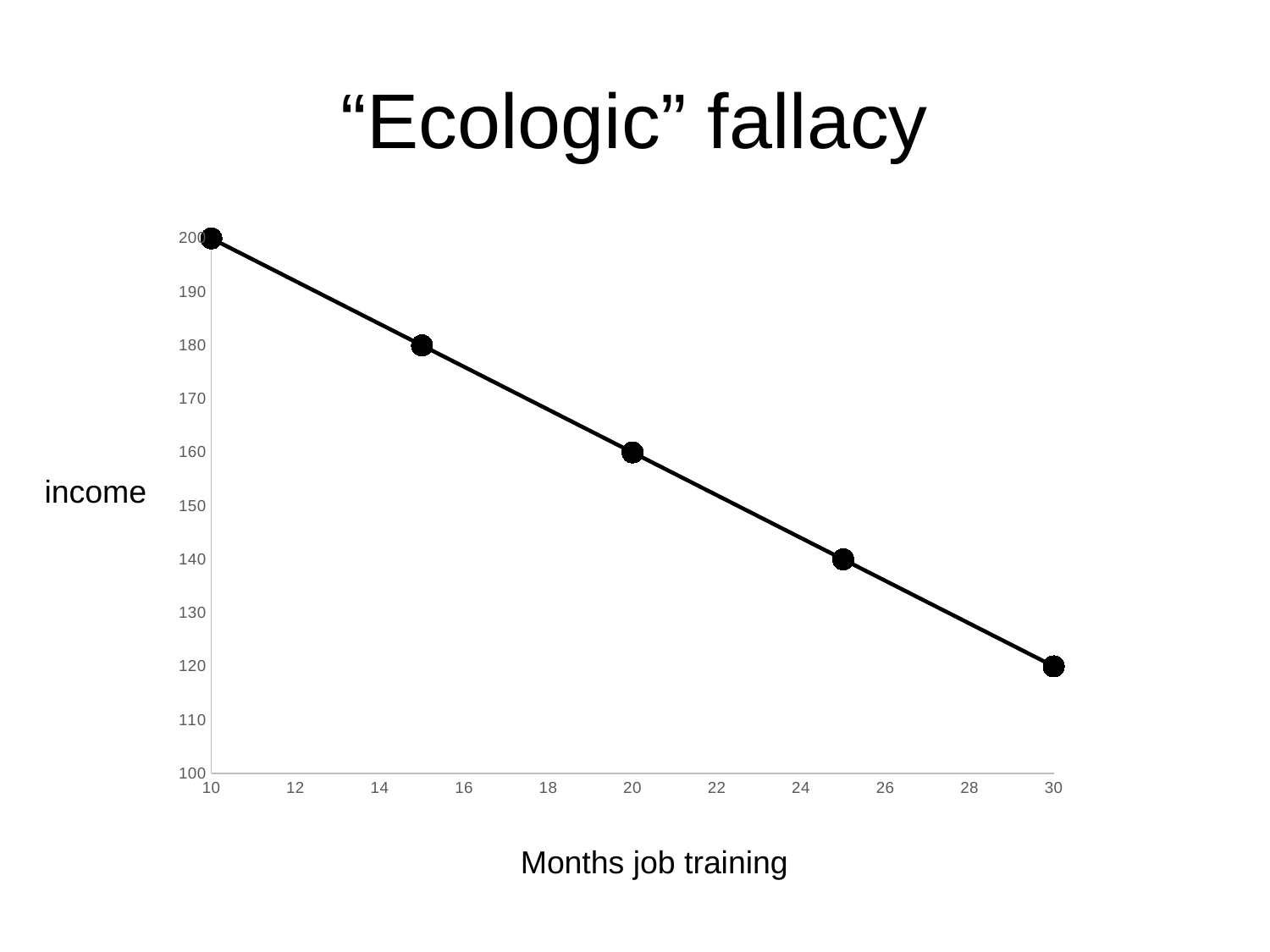
Does income rise or fall as months of job training increase? fall Is the income value at 20 months of job training greater or less than 150? greater At which number of months of job training is income highest? 10 What kind of chart is shown on the slide? line chart What is the income value at 20 months of job training? 160 What is the income value at 30 months of job training? 120 What is the difference in income between 10 months and 30 months of job training? 80 At which number of months of job training is income lowest? 30 Which has the larger income value: 10 months or 20 months of job training? 10 months What is the income value at 10 months of job training? 200 What is the label of the x axis? Months job training How many data points are plotted on the chart? 5